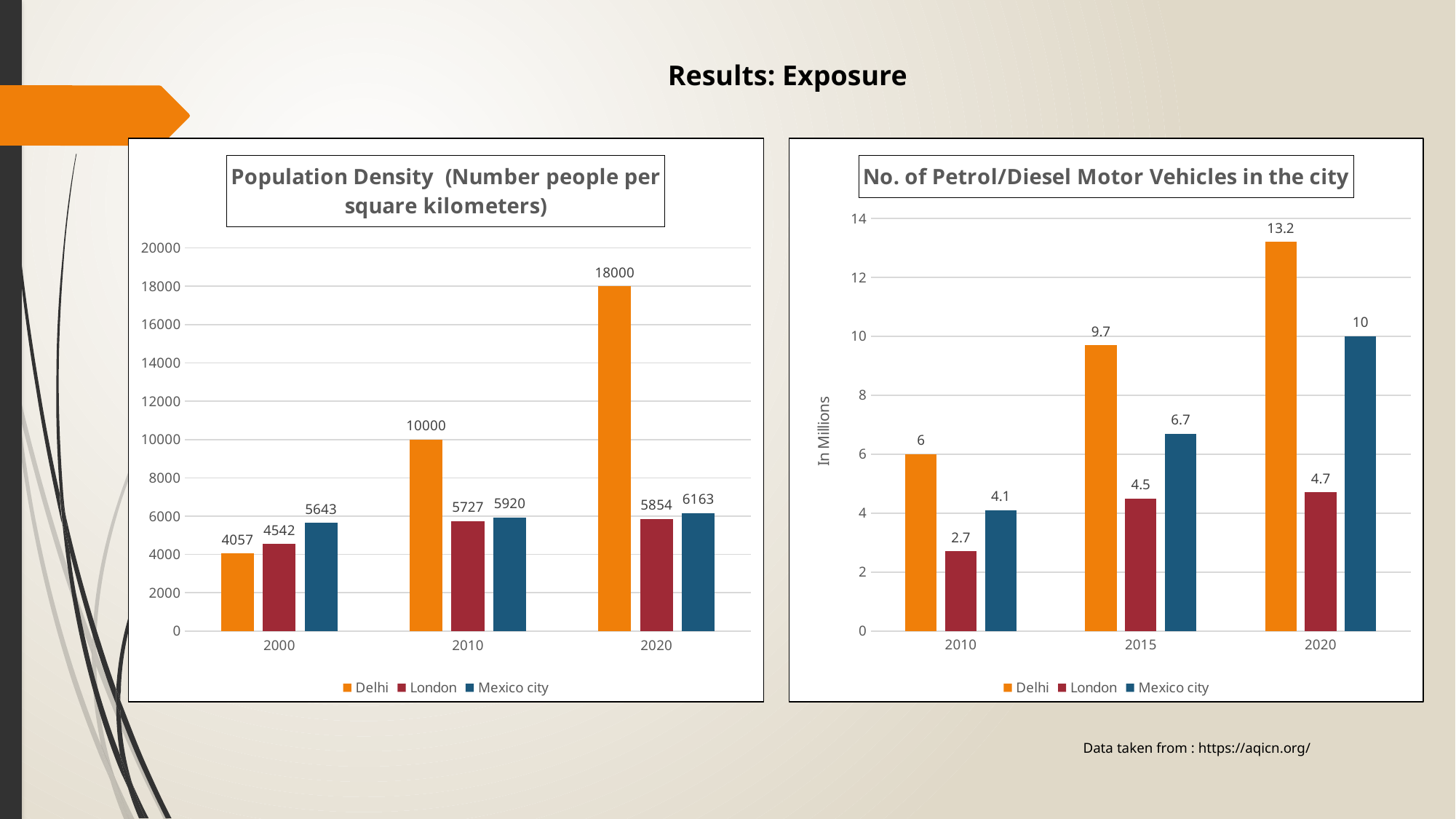
In the No. of Petrol/Diesel Motor Vehicles chart, what is the difference between Delhi and London in 2010? 3.3 In the Population Density chart, what is the value for London in 2000? 4542 In the Population Density chart, how many series does the legend list? 3 In the Population Density chart, which city has the lowest value in 2000? Delhi In the No. of Petrol/Diesel Motor Vehicles chart, which city has the highest value in 2020? Delhi In the No. of Petrol/Diesel Motor Vehicles chart, which is larger in 2015: London or Mexico city? Mexico city In the No. of Petrol/Diesel Motor Vehicles chart, how many year categories are shown on the x axis? 3 What kind of chart is the No. of Petrol/Diesel Motor Vehicles chart? bar chart In the Population Density chart, what is the value for Delhi in 2020? 18000 In the No. of Petrol/Diesel Motor Vehicles chart, what is the value for Mexico city in 2015? 6.7 In the Population Density chart, what is the difference between Mexico city and London in 2010? 193 In the Population Density chart, does Delhi's value rise or fall from 2000 to 2020? rise